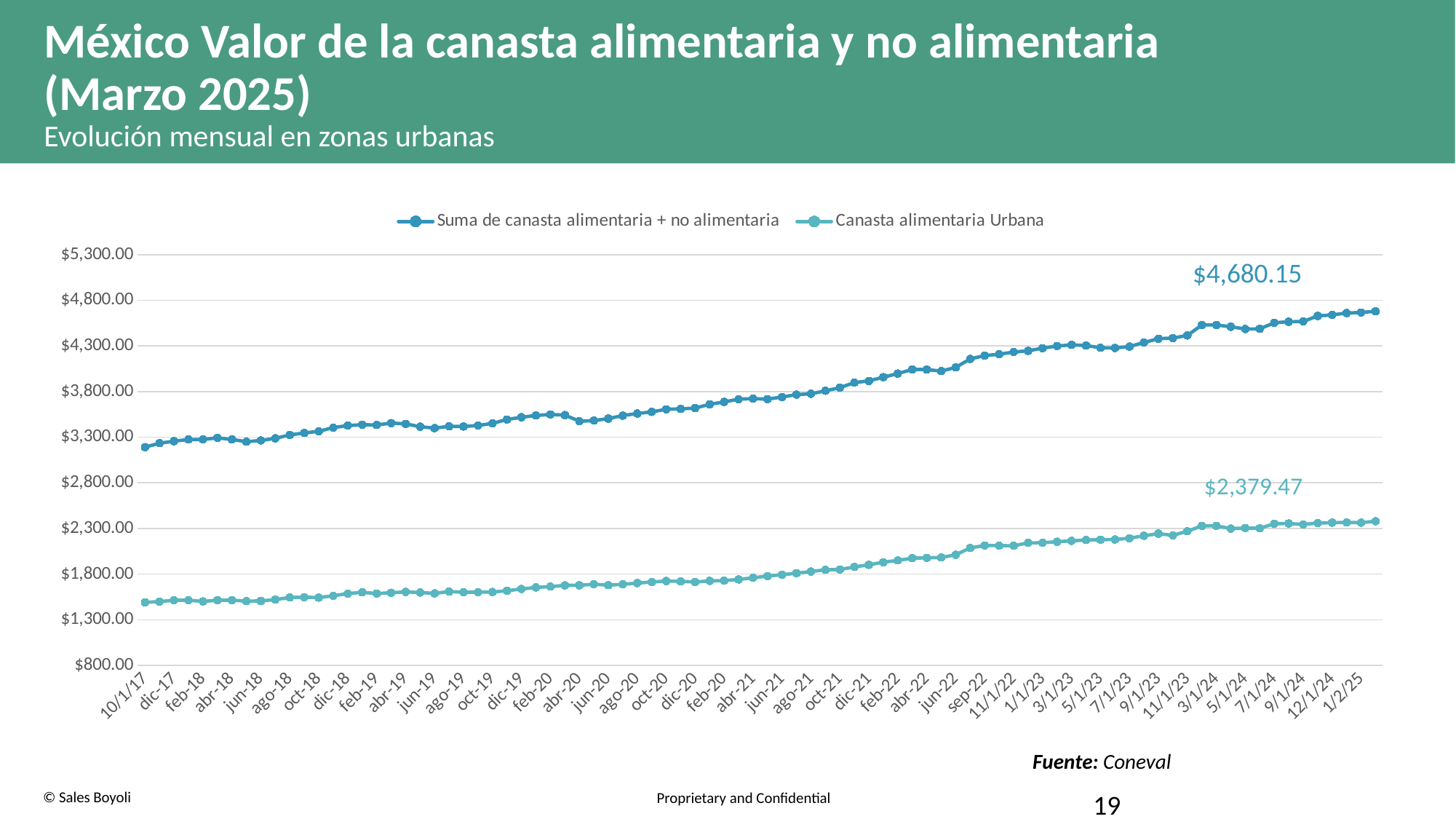
Which series has the higher values throughout the chart, 'Suma de canasta alimentaria + no alimentaria' or 'Canasta alimentaria Urbana'? Suma de canasta alimentaria + no alimentaria Is the value for 'Suma de canasta alimentaria + no alimentaria' at 10/1/17 greater or less than $3,300.00? less Do the values of 'Canasta alimentaria Urbana' generally rise or fall from 10/1/17 to 1/2/25? rise Is the value for 'Suma de canasta alimentaria + no alimentaria' at 1/2/25 greater or less than $4,300.00? greater Is the value for 'Canasta alimentaria Urbana' at 10/1/17 greater or less than $1,800.00? less What type of chart is shown on the slide? line chart What is the difference between the two labelled values, $4,680.15 and $2,379.47? $2,300.68 What is the latest labelled value for the series 'Suma de canasta alimentaria + no alimentaria'? $4,680.15 How many series does the legend list? 2 Do the values of 'Suma de canasta alimentaria + no alimentaria' generally rise or fall over the period shown? rise What is the latest labelled value for the series 'Canasta alimentaria Urbana'? $2,379.47 What is the subtitle shown under the chart's main title? Evolución mensual en zonas urbanas